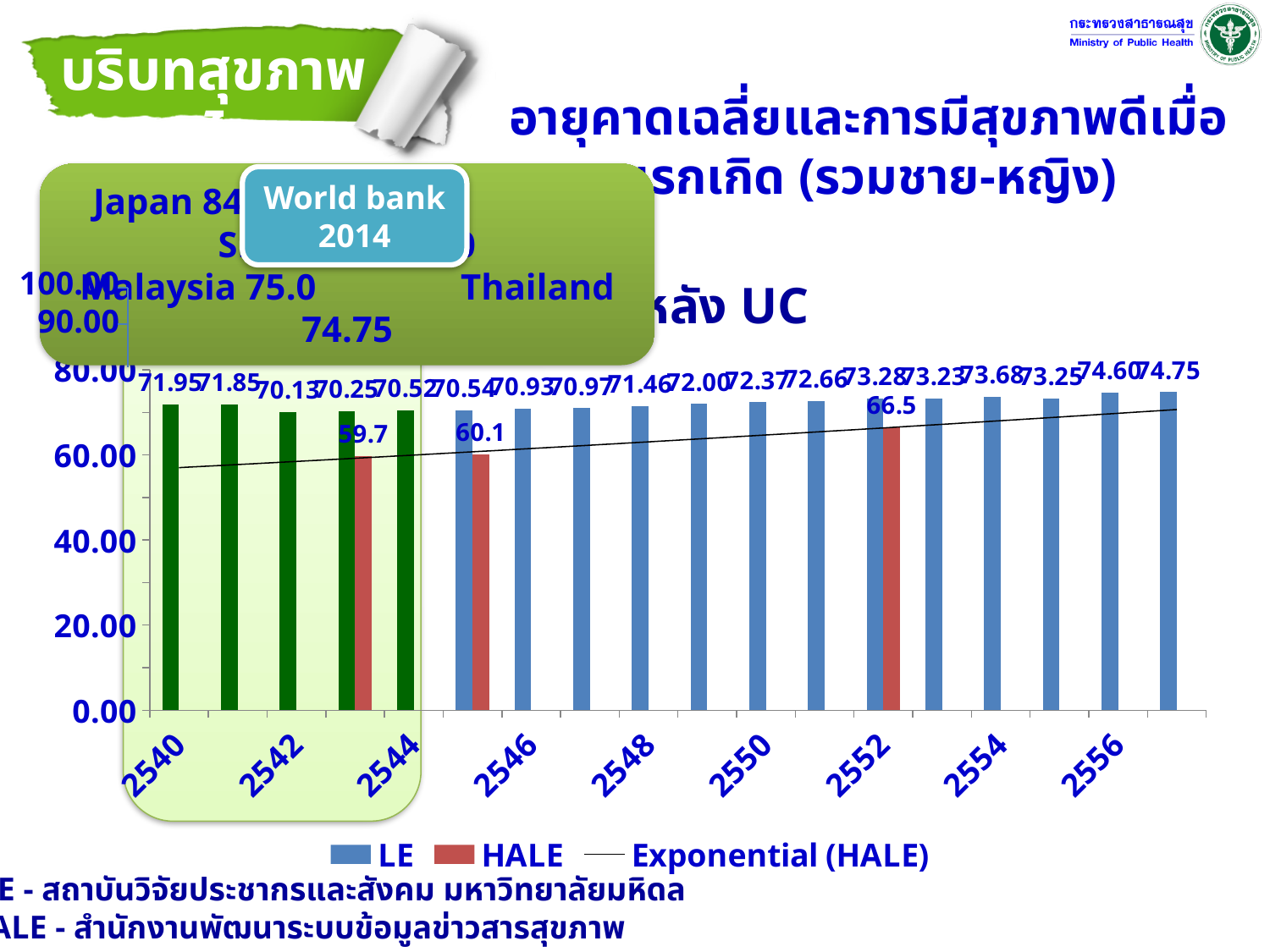
How many years are shown on the x axis with LE bars? 18 What is the difference between the HALE value for 2552 and the HALE value for 2543? 6.8 Is the HALE value for 2545 greater or less than 80.00? less What is the HALE value for 2552? 66.5 What is the LE value for 2557? 74.75 Do the HALE values rise or fall from 2543 to 2552? rise How many series does the legend list? 3 Which year has the lowest LE value? 2542 What kind of chart is shown on the slide? bar chart Which is larger, the LE value for 2540 or the LE value for 2541? 2540 Which year has the highest LE value? 2557 What is the LE value for 2540? 71.95